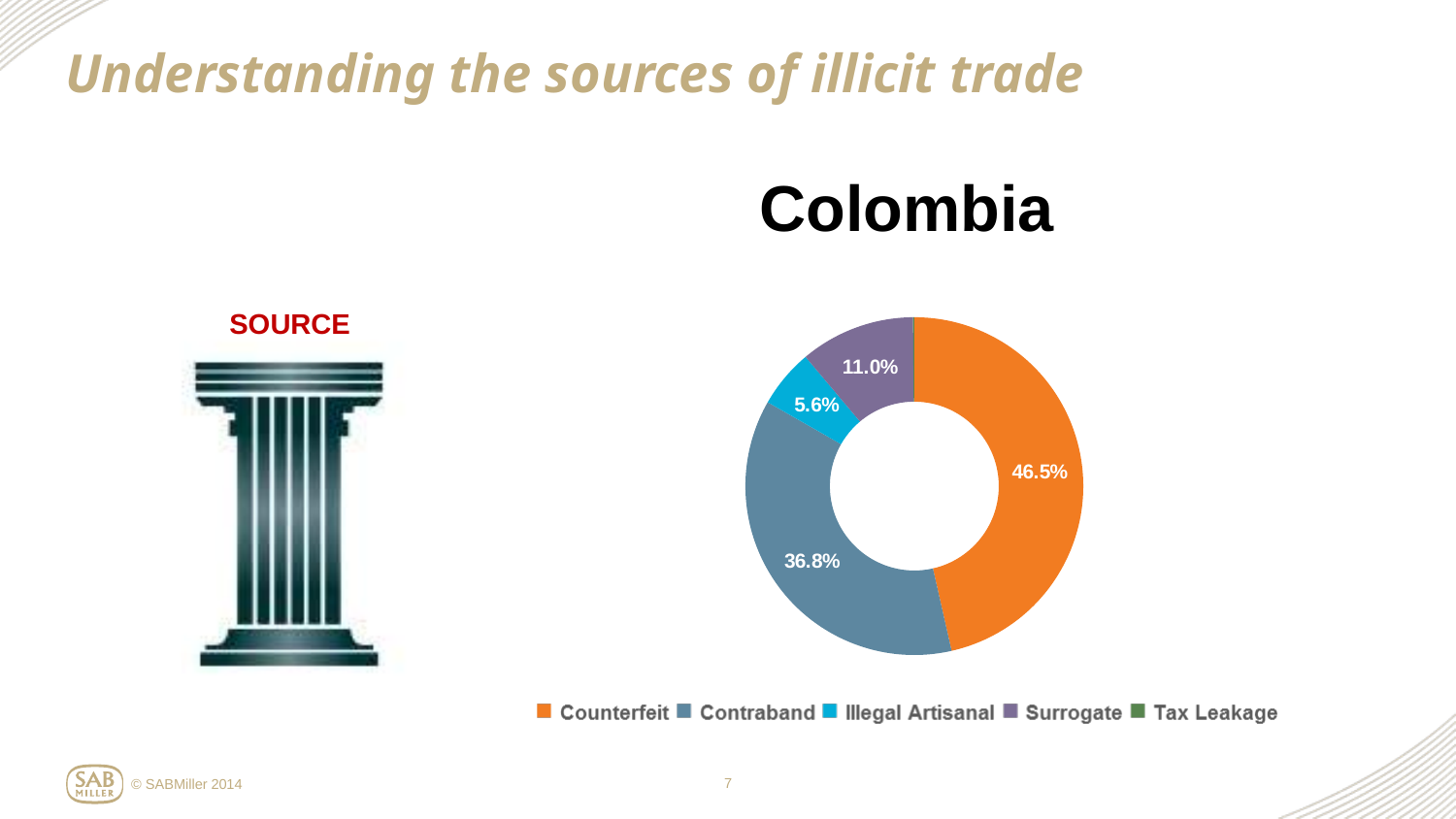
Which source has the largest share in the Colombia chart? Counterfeit How many slices with data labels are shown in the doughnut chart? 4 Which labelled source has the smallest share in the Colombia chart? Illegal Artisanal What share of the Colombia chart is Contraband? 36.8% What share of the Colombia chart is Illegal Artisanal? 5.6% What kind of chart is shown on the slide? Doughnut (pie) chart Which is larger, the Surrogate share or the Illegal Artisanal share? Surrogate How many entries does the legend list? 5 What is the difference between the Counterfeit and Contraband shares? 9.7% Which country does the chart title refer to? Colombia What share of the Colombia chart is Surrogate? 11.0% What share of the Colombia chart is Counterfeit? 46.5%